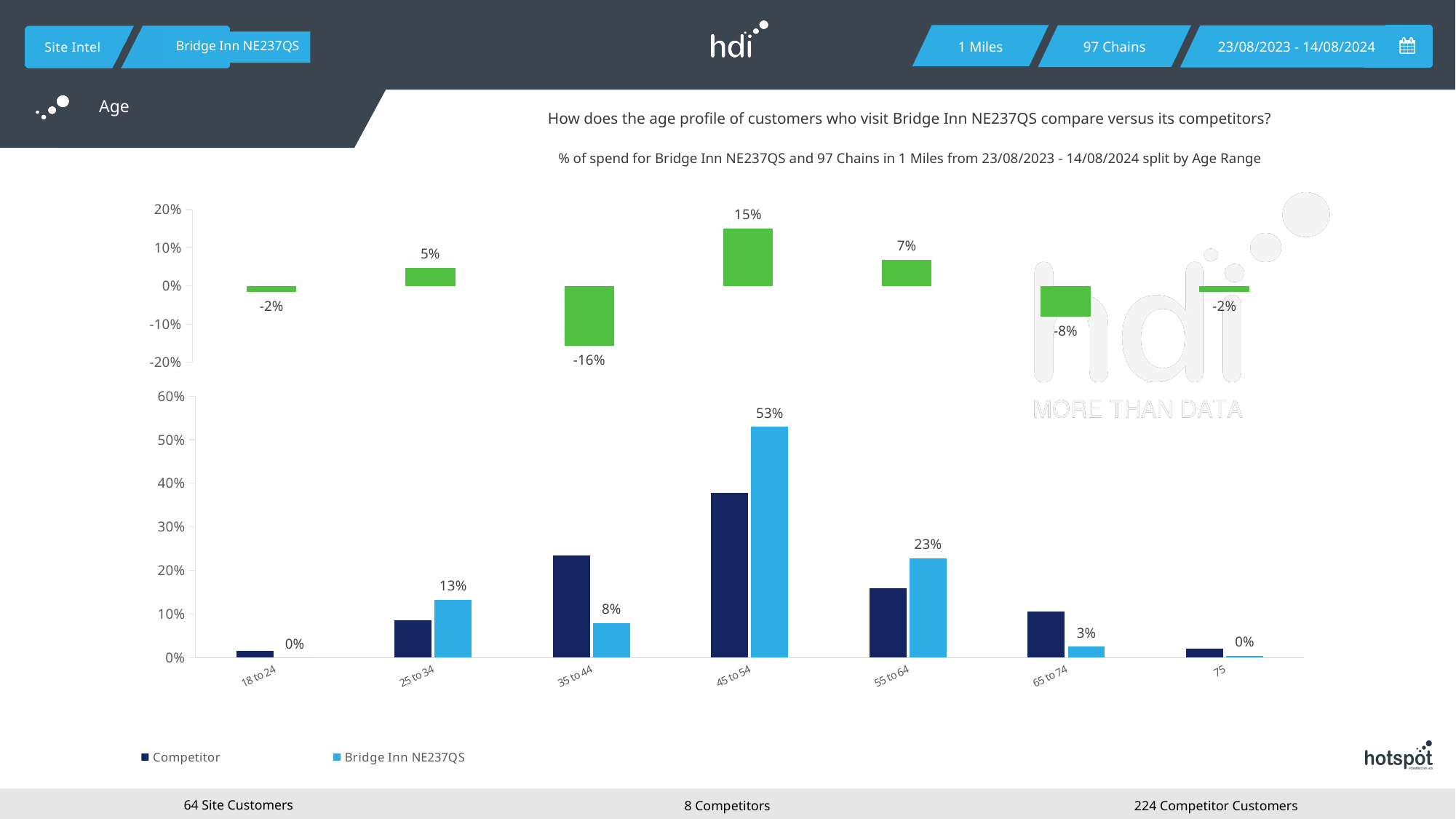
How many age range categories are shown on the x axis of the bottom chart? 7 In the top chart, which age range has the lowest value? 35 to 44 In the top chart, what is the value shown for the 35 to 44 age range? -16% In the bottom chart, what is the difference between the Bridge Inn NE237QS values for 45 to 54 and 55 to 64? 30% In the bottom chart, is the Competitor value for the 45 to 54 age range greater or less than 30%? greater How many series does the legend of the bottom chart list? 2 In the bottom chart, what is the value for Bridge Inn NE237QS in the 25 to 34 age range? 13% In the bottom chart, what is the value for Bridge Inn NE237QS in the 45 to 54 age range? 53% In the bottom chart, which age range has the highest value for Bridge Inn NE237QS? 45 to 54 In the bottom chart, for the 35 to 44 age range, which series has the larger value: Competitor or Bridge Inn NE237QS? Competitor In the top chart, what is the value shown for the 45 to 54 age range? 15% What type of chart is the bottom chart? bar chart